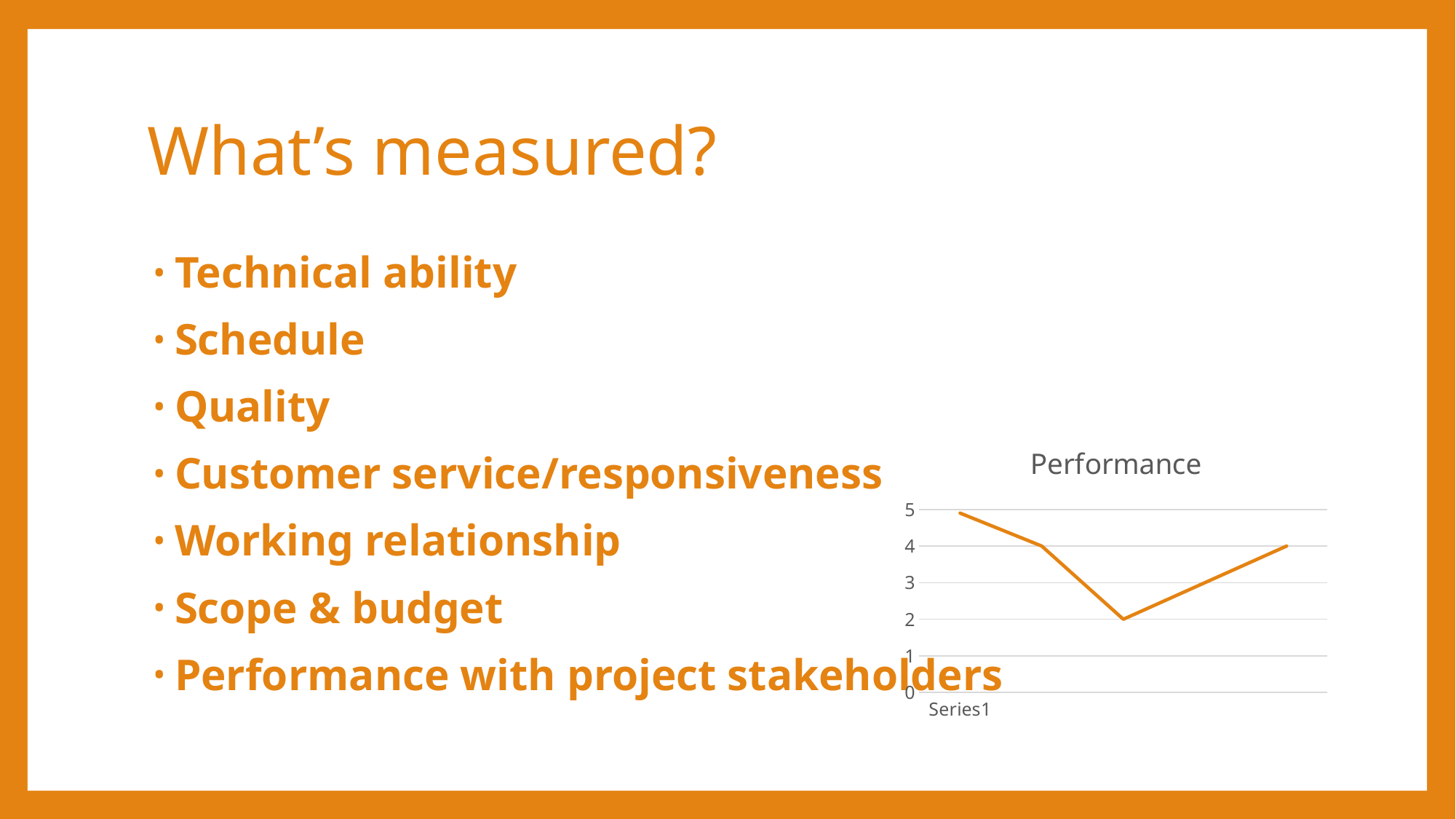
What is the value of the last point on the Performance line? 4 What is the value of the lowest point on the Performance line? 2 Which is larger on the Performance line, the second point or the third point? the second point Does the Performance line rise or fall from the third point to the last point? rise Does the Performance line rise or fall from the first point to the third point? fall What is the title of the chart on the slide? Performance What kind of chart is shown on the slide? line chart Is the value of the first point on the Performance line greater or less than 4? greater What label appears on the x axis of the Performance chart? Series1 Which point on the Performance line is the lowest? the third point What is the difference between the second point and the third point on the Performance line? 2